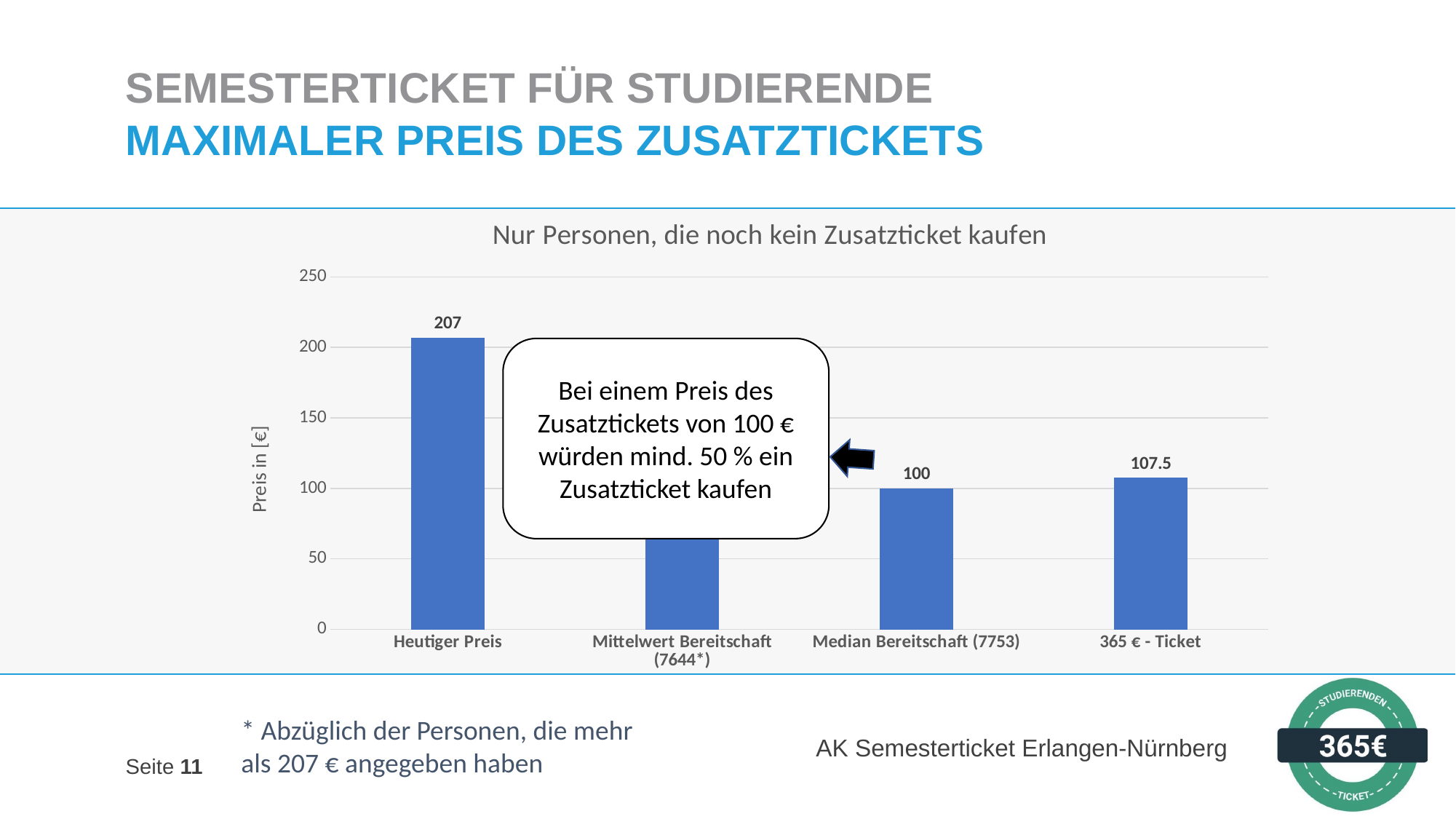
What is the value for Heutiger Preis? 207 What is the value for 365 € - Ticket? 107.5 Which category has the highest value? Heutiger Preis Is the value for Heutiger Preis greater or less than 200? greater What is the difference between 365 € - Ticket and Median Bereitschaft (7753)? 7.5 What is the label of the y axis? Preis in [€] How many categories are shown on the x axis? 4 Which is larger, the value for 365 € - Ticket or the value for Median Bereitschaft (7753)? 365 € - Ticket What is the difference between Heutiger Preis and Median Bereitschaft (7753)? 107 What kind of chart is shown on the slide? bar chart What is the value for Median Bereitschaft (7753)? 100 What is the title of the chart? Nur Personen, die noch kein Zusatzticket kaufen